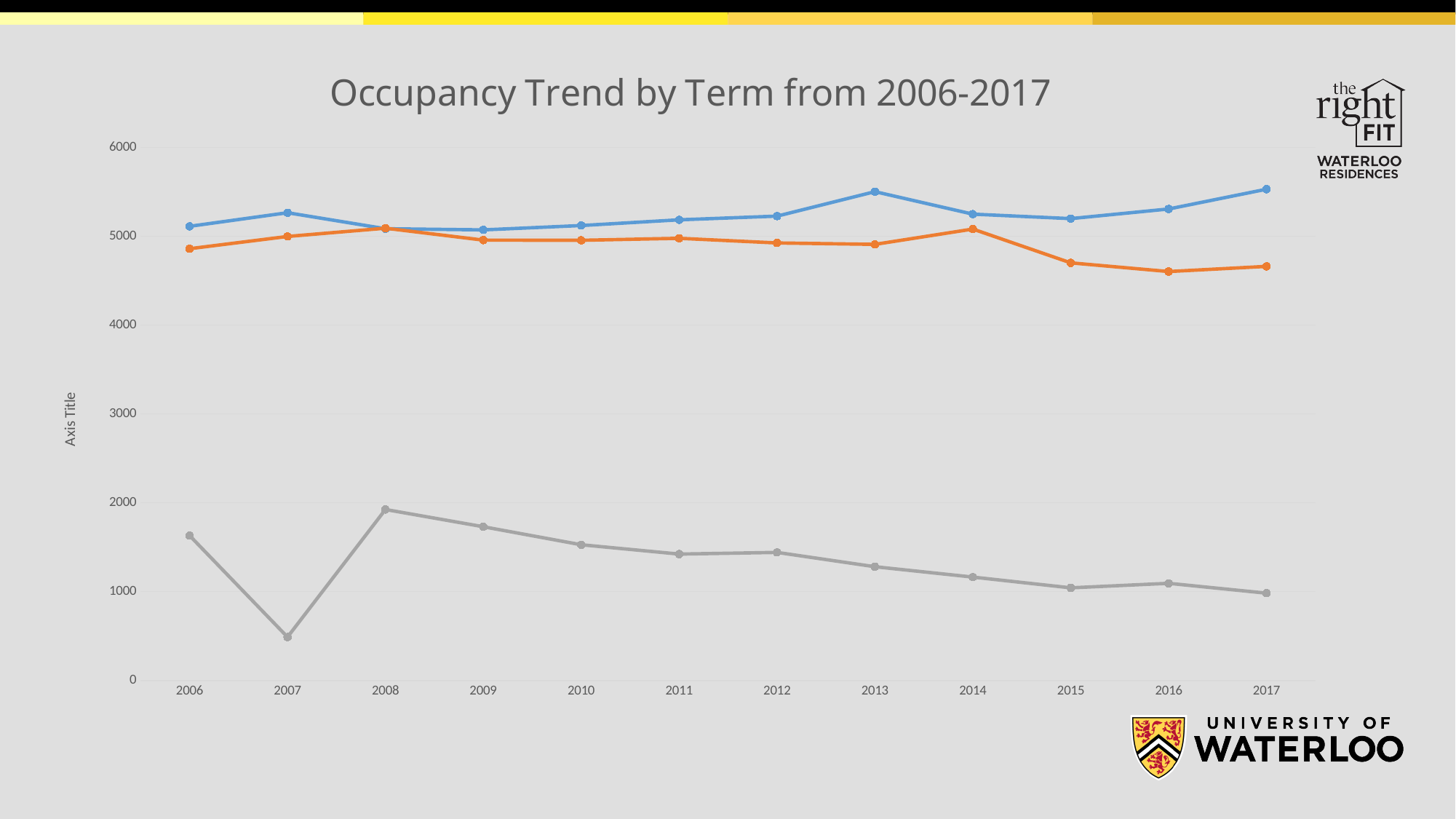
How many years are shown along the x axis of the chart? 12 Is the value of the orange line in 2006 greater or less than 5000? less What type of chart is shown on the slide? line chart Is the value of the blue line in 2006 greater or less than 5000? greater Is the value of the grey line in 2007 greater or less than 1000? less In which year does the grey line reach its lowest value? 2007 In 2017, which line has the higher value, the blue line or the orange line? blue line What is the title of the chart? Occupancy Trend by Term from 2006-2017 How many lines are plotted on the chart? 3 What is the label on the vertical axis of the chart? Axis Title